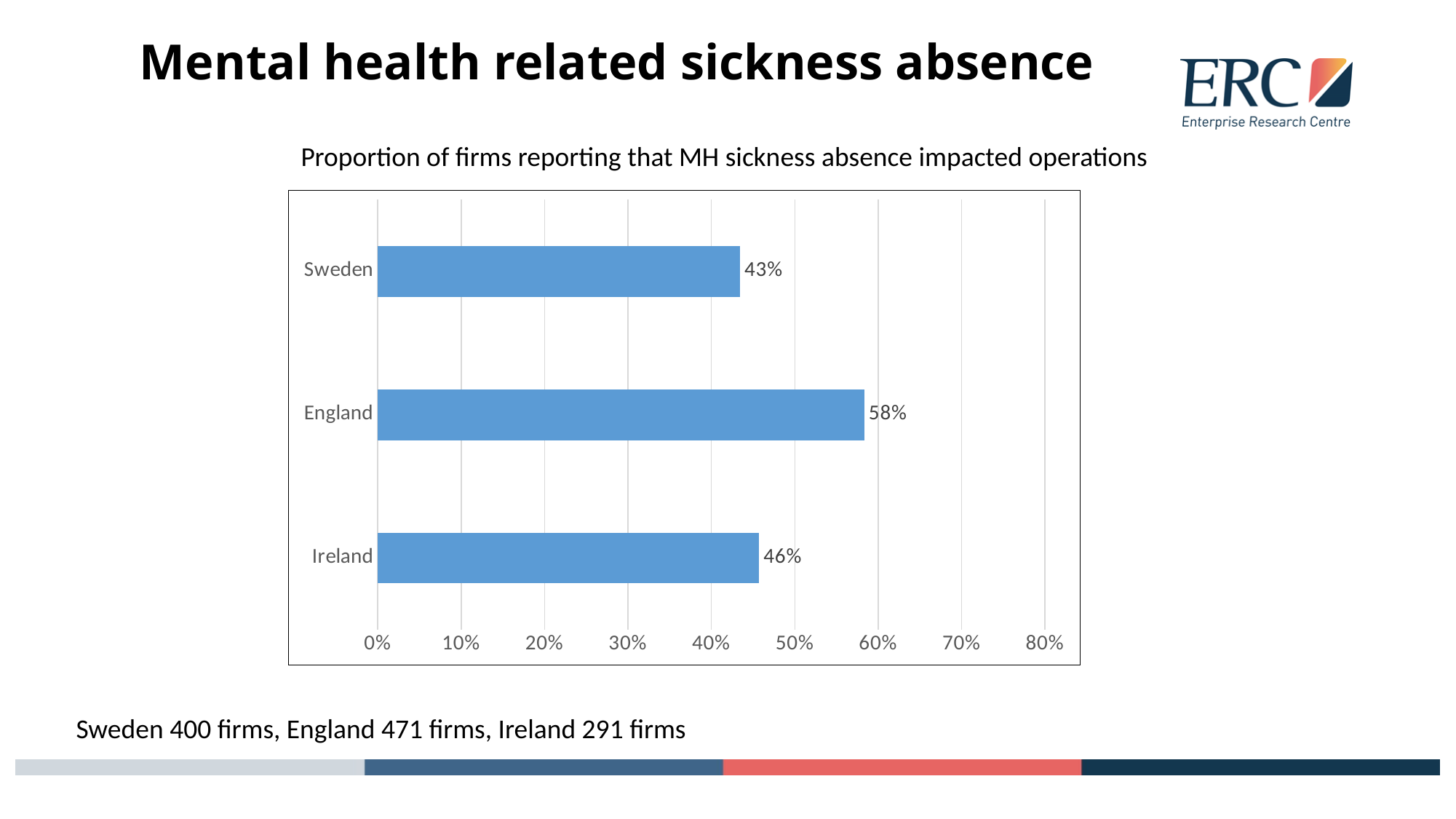
What proportion of firms in Sweden reported that MH sickness absence impacted operations? 43% Which country has the lowest proportion of firms reporting that MH sickness absence impacted operations? Sweden What is the difference in percentage points between England and Sweden? 15 percentage points Which country has the highest proportion of firms reporting that MH sickness absence impacted operations? England Is the value for England greater or less than 50%? greater Which has a higher value, Ireland or Sweden? Ireland What kind of chart is shown on the slide? Bar chart What is the title of the chart? Proportion of firms reporting that MH sickness absence impacted operations What is the difference in percentage points between Ireland and Sweden? 3 percentage points How many countries are shown in the chart? 3 What proportion of firms in Ireland reported that MH sickness absence impacted operations? 46% What proportion of firms in England reported that MH sickness absence impacted operations? 58%